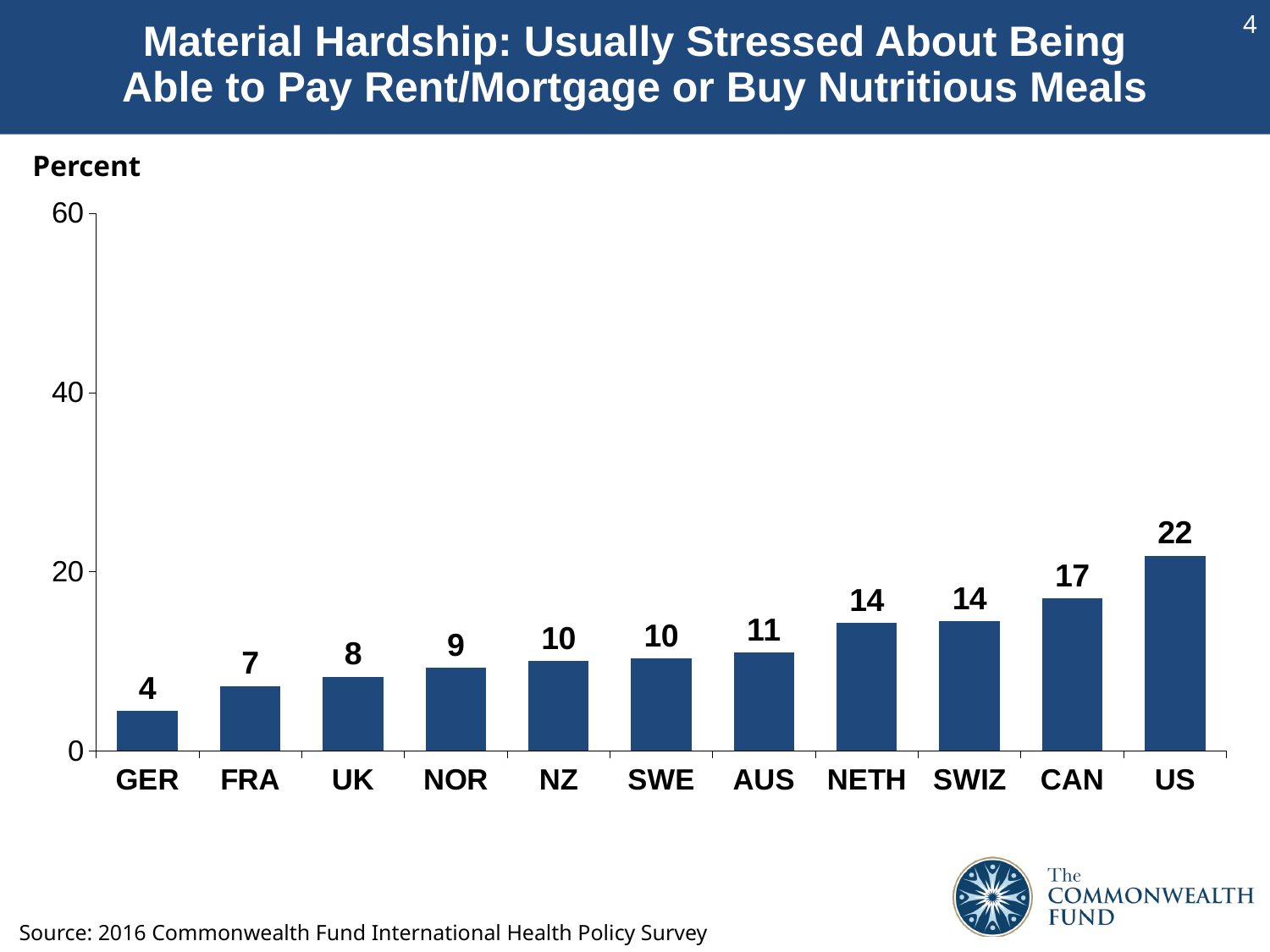
Which is larger, the value for AUS or the value for UK? AUS Is the value for the US greater or less than 20? greater Which country has the lowest value? GER What kind of chart is shown on the slide? bar chart What is the difference between the values for the US and CAN? 5 What is the value for the US? 22 What is the difference between the values for FRA and GER? 3 How many countries are shown on the chart? 11 Do the values rise or fall from left to right along the x axis? rise What is the value for GER? 4 Which country has the highest value? US What is the value for NETH? 14